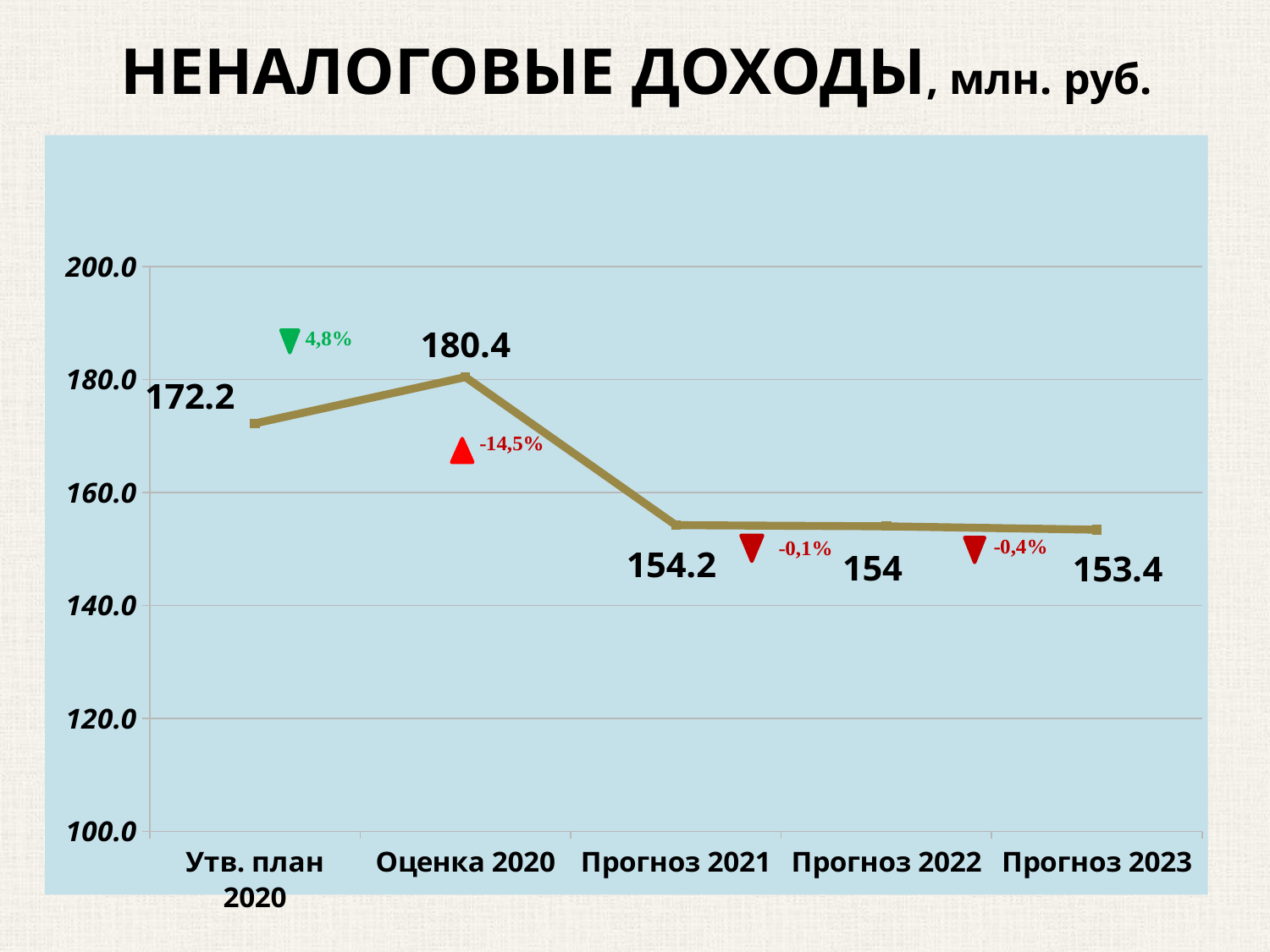
How many data points are plotted on the chart? 5 What is the value for Оценка 2020? 180.4 What is the title of the chart? НЕНАЛОГОВЫЕ ДОХОДЫ, млн. руб. Which category has the lowest value? Прогноз 2023 What is the difference between the values for Оценка 2020 and Утв. план 2020? 8.2 What is the value for Прогноз 2022? 154 What is the difference between the values for Оценка 2020 and Прогноз 2021? 26.2 What is the value for Утв. план 2020? 172.2 Which category has the highest value? Оценка 2020 What is the value for Прогноз 2023? 153.4 What kind of chart is shown on the slide? Line chart Which is larger, the value for Утв. план 2020 or the value for Прогноз 2021? Утв. план 2020